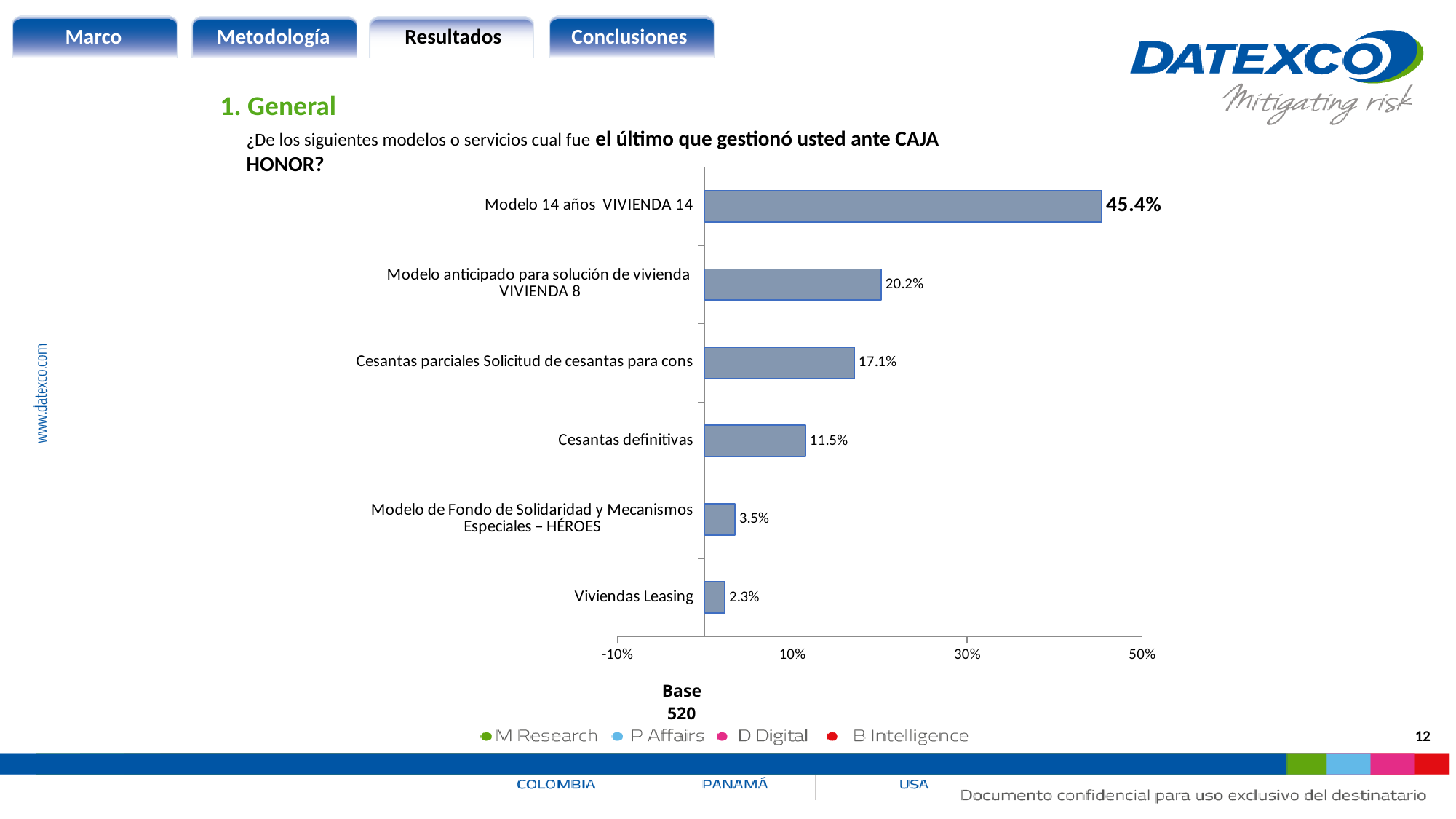
Which category has the lowest value? Viviendas Leasing What is the value for Cesantas definitivas? 11.5% What kind of chart is shown on the slide? bar chart How many categories are shown in the chart? 6 Which category has the highest value? Modelo 14 años VIVIENDA 14 What is the value for Modelo anticipado para solución de vivienda VIVIENDA 8? 20.2% What is the base (number of respondents) shown below the chart? 520 What is the value for Viviendas Leasing? 2.3% Is the value for Modelo de Fondo de Solidaridad y Mecanismos Especiales – HÉROES greater or less than 10%? less Which is larger: Cesantas parciales Solicitud de cesantas para cons or Cesantas definitivas? Cesantas parciales Solicitud de cesantas para cons What is the value for Modelo 14 años VIVIENDA 14? 45.4% What is the difference between Modelo 14 años VIVIENDA 14 and Modelo anticipado para solución de vivienda VIVIENDA 8? 25.2%